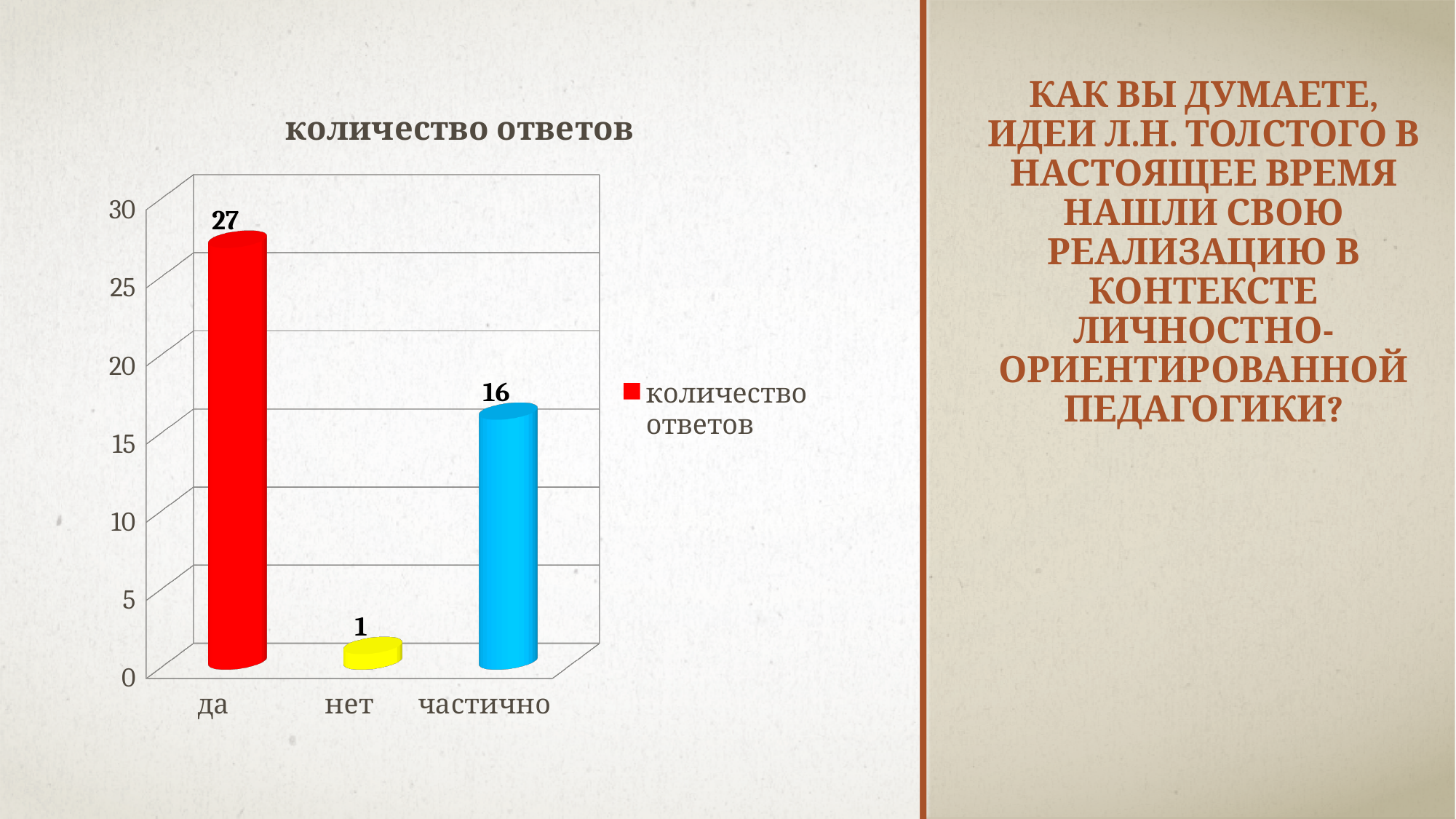
What is the value for "да"? 27 Is the value for "частично" greater or less than 20? less How many categories are shown on the x axis? 3 What is the value for "частично"? 16 What is the value for "нет"? 1 How many series does the legend list? 1 Which category has the highest value? да Which category has the lowest value? нет What is the difference between the values for "да" and "частично"? 11 What kind of chart is shown on the slide? bar chart What is the title of the chart? количество ответов Which is larger, the value for "частично" or the value for "нет"? частично